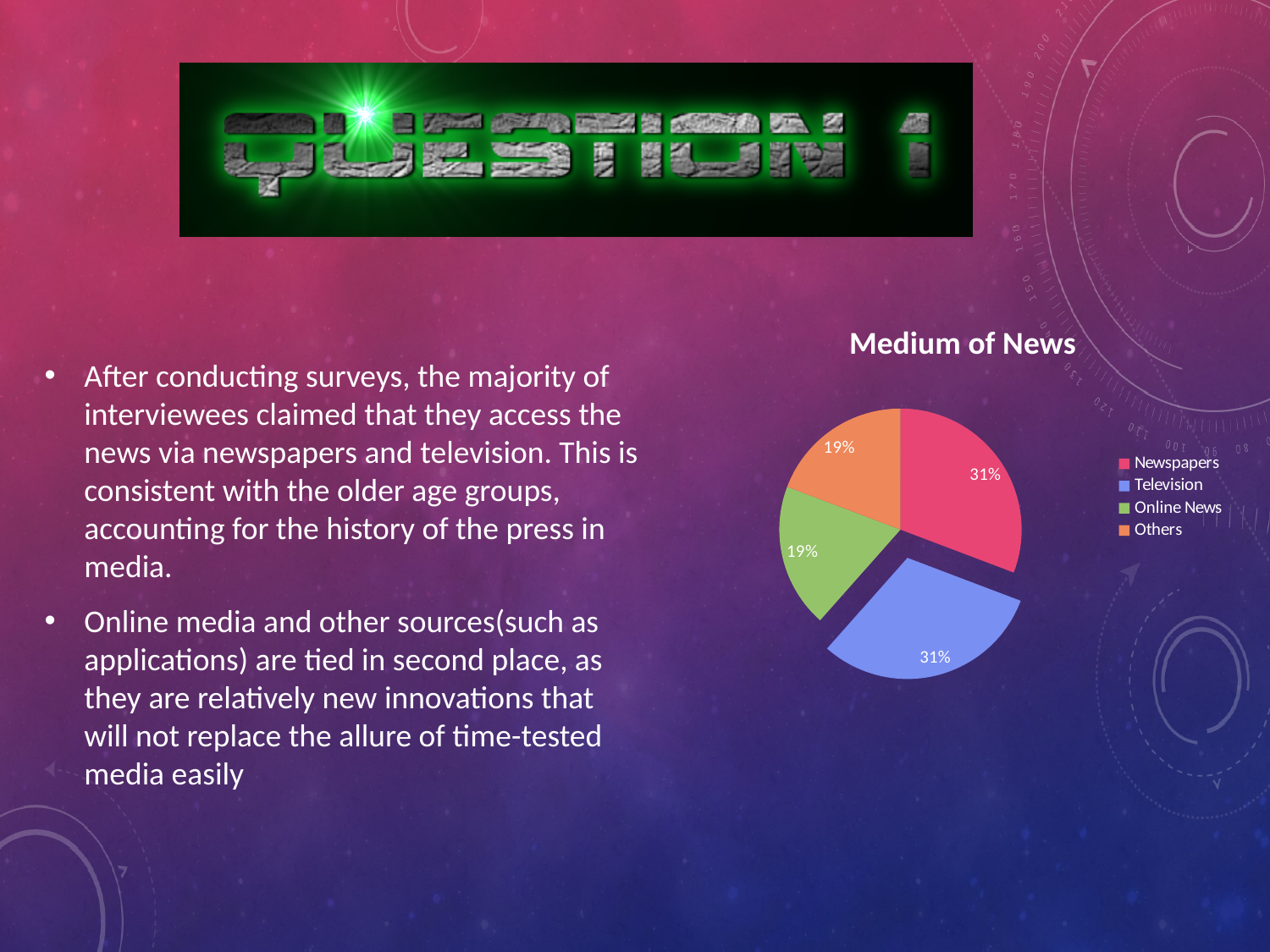
What is the difference between the share for Television and the share for Others? 12% Which is larger, the share for Newspapers or the share for Online News? Newspapers Which is larger, the share for Others or the share for Television? Television Which colour represents Online News in the pie chart? green What share of the pie does Newspapers account for? 31% What share of the pie does Online News account for? 19% What share of the pie does Television account for? 31% How many slices does the pie chart have? 4 What type of chart is shown on the slide? pie chart What is the title of the chart? Medium of News How many entries does the legend list? 4